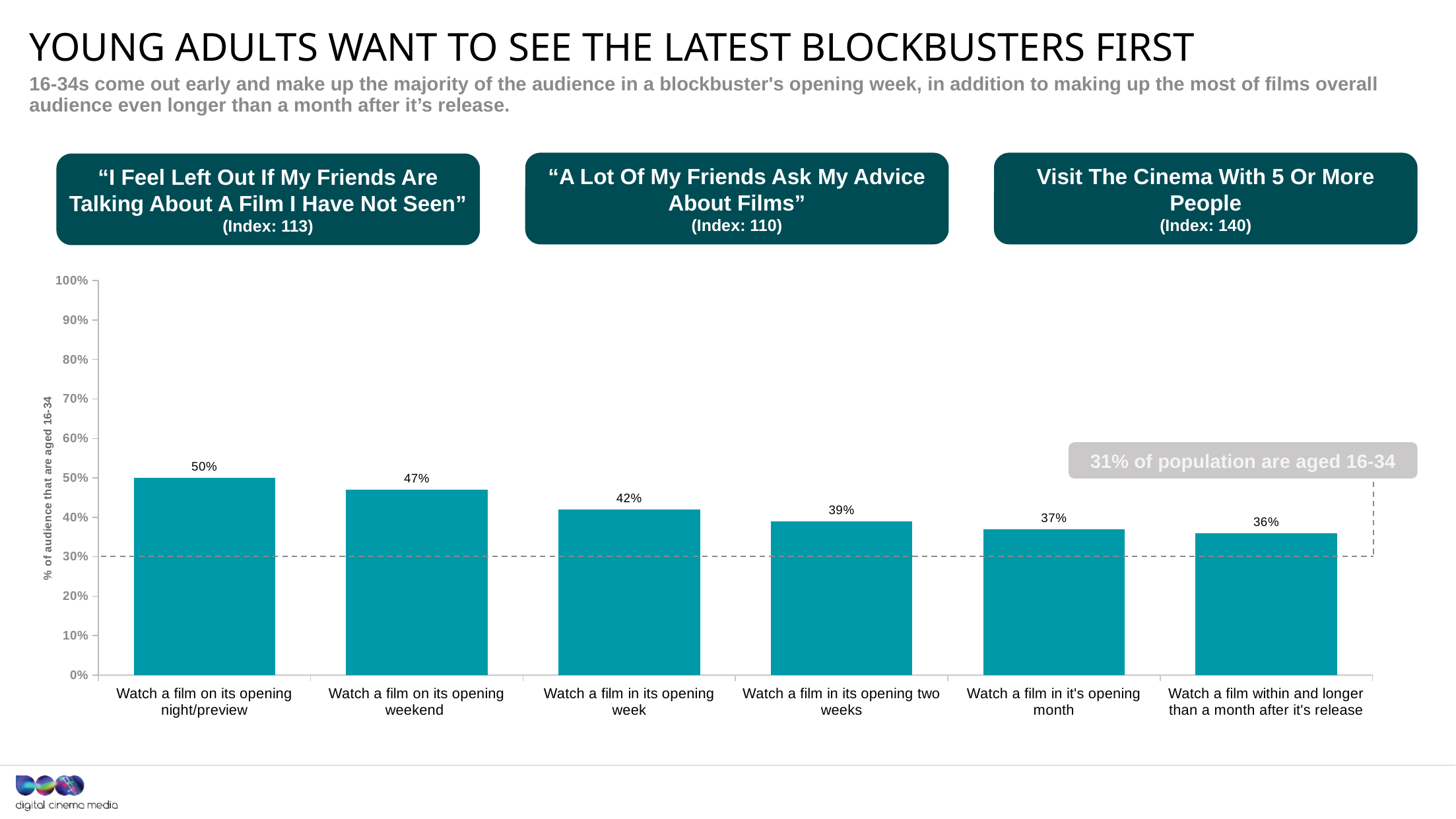
Which category has the lowest percentage of audience aged 16-34? Watch a film within and longer than a month after it's release Is the value for 'Watch a film in its opening week' greater or less than 40%? greater Do the values rise or fall moving from left to right along the x axis? fall What percentage of the audience that watch a film on its opening night/preview are aged 16-34? 50% What is the difference between the values for 'Watch a film on its opening weekend' and 'Watch a film in its opening week'? 5% What is the label on the y axis of the chart? % of audience that are aged 16-34 Which category has the highest percentage of audience aged 16-34? Watch a film on its opening night/preview Which is larger: the value for 'Watch a film in it's opening month' or 'Watch a film in its opening two weeks'? Watch a film in its opening two weeks What is the value for 'Watch a film in its opening two weeks'? 39% How many categories are shown on the x axis of the chart? 6 What kind of chart is shown on the slide? bar chart What is the value for 'Watch a film within and longer than a month after it's release'? 36%